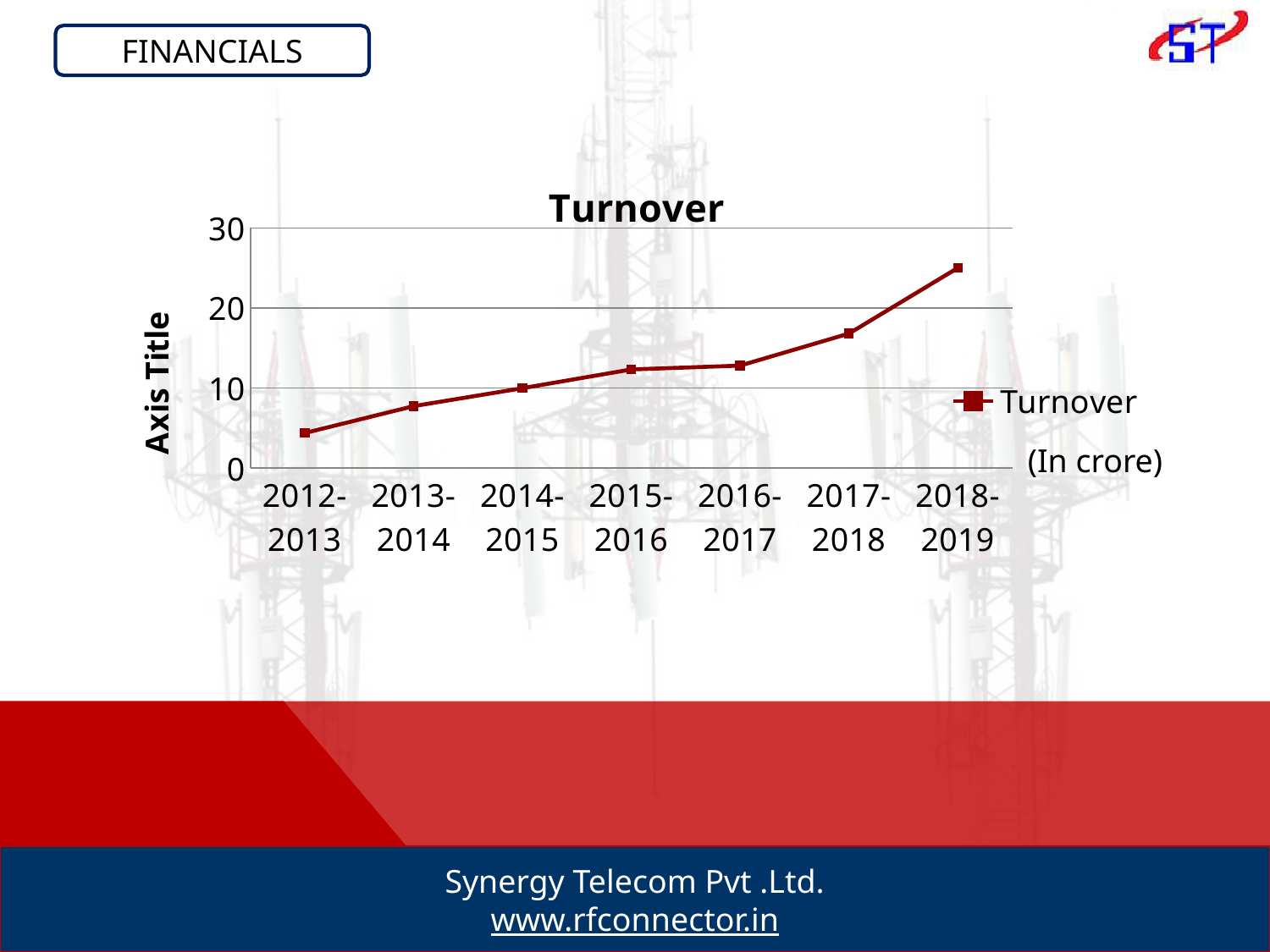
Is the turnover for 2017-2018 greater or less than 20? less Is the turnover for 2018-2019 greater or less than 20? greater What is the title of the chart? Turnover Which period has the lowest turnover? 2012-2013 Which is larger, the turnover for 2013-2014 or for 2017-2018? 2017-2018 Does turnover rise or fall from 2012-2013 to 2018-2019? rise What unit is given next to the legend for the turnover values? In crore Which period has the highest turnover? 2018-2019 Is the turnover for 2012-2013 greater or less than 10? less How many series does the legend list? 1 How many periods are plotted along the x axis? 7 What kind of chart is shown on the slide? line chart